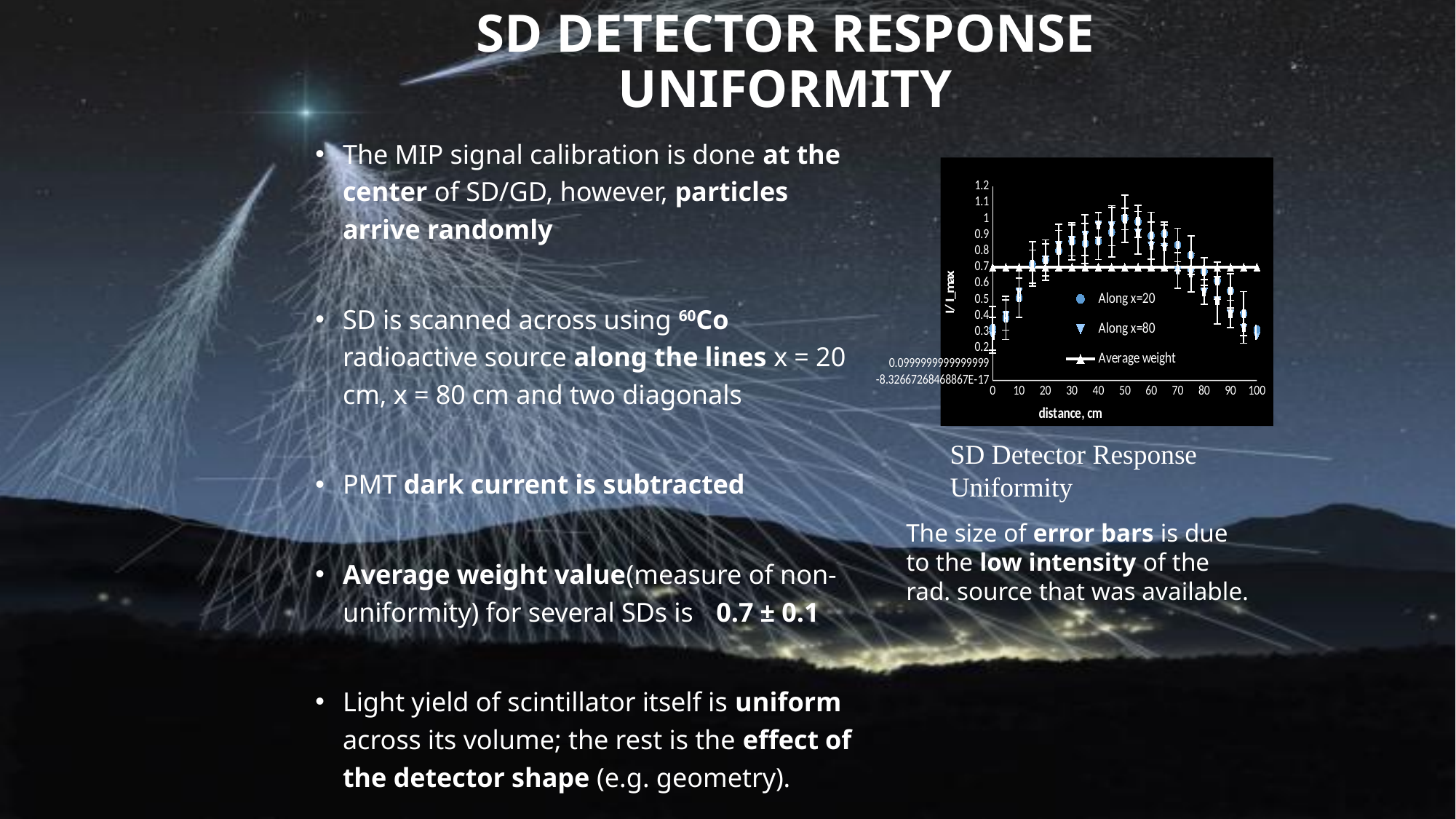
Is the Along x=80 value at distance 100 cm greater or less than 0.5? less Is the Average weight series value greater or less than 0.6? greater What is the label of the x axis of the chart? distance, cm At distance 0 cm, which is larger: the Average weight value or the Along x=20 value? Average weight Is the Along x=20 value at distance 50 cm greater or less than 0.8? greater Do the Along x=20 values rise or fall as distance increases from 0 cm to 50 cm? rise What kind of chart is shown on the slide? Scatter chart with error bars How many series does the chart legend list? 3 Do the Along x=80 values rise or fall as distance increases from 50 cm to 100 cm? fall What are the three series named in the chart legend? Along x=20, Along x=80, Average weight